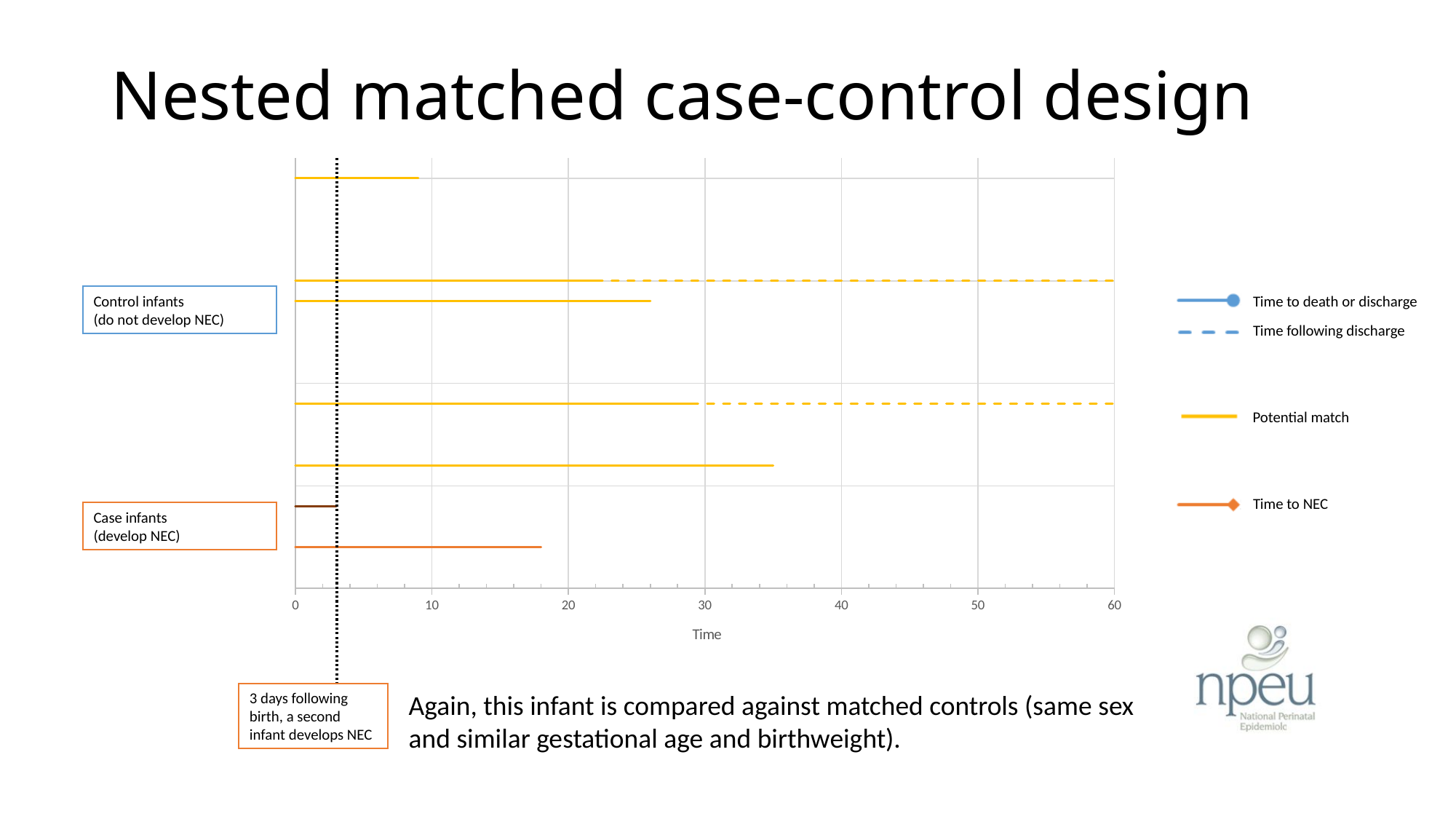
What is the highest value shown on the x axis of the chart? 60 Is the end of the short dark line at the top of the case infants group greater or less than 10? less How many entries does the chart's legend list? 4 Which of the two case infant lines extends further along the time axis, the upper one or the lower one? the lower one At what time value is the vertical dotted line on the chart drawn? 3 days How many horizontal lines (infants) are plotted on the chart? 7 Is the end of the lowest orange 'Time to NEC' line on the chart greater or less than 20? less Of the two solid 'Potential match' lines, which extends further along the time axis, the upper or the lower? the lower Is the end of the lowest solid 'Potential match' line on the chart greater or less than 30? greater What is the title of the x axis on the chart? Time Up to what time value do the dashed 'Time following discharge' lines extend on the chart? 60